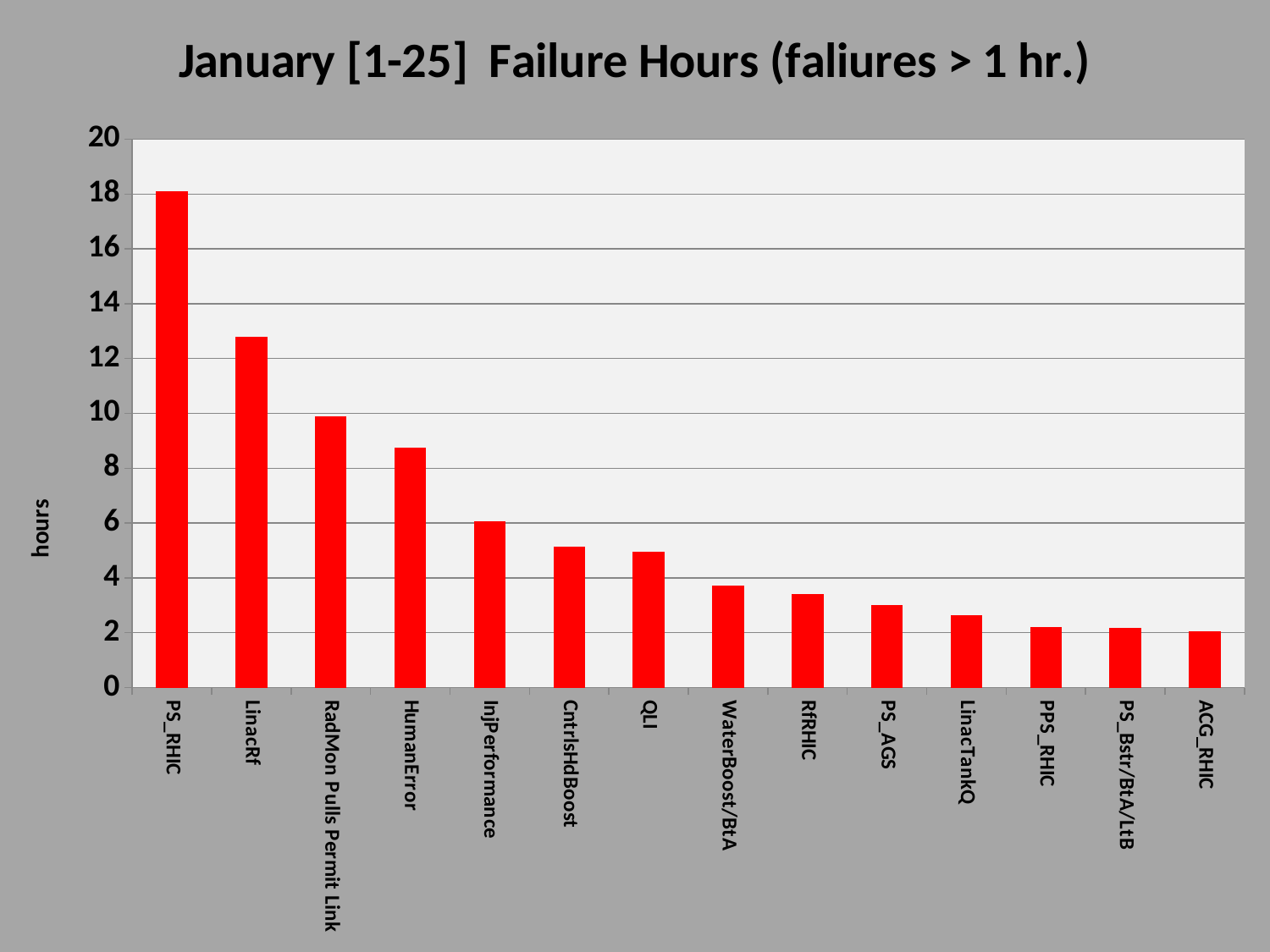
How many categories are plotted on the chart? 14 What kind of chart is shown on the slide? bar chart Is the value for CntrlsHdBoost greater or less than 4? greater Which has more failure hours, LinacRf or HumanError? LinacRf Do the values rise or fall moving from left to right along the x axis? fall What is the label on the vertical axis? hours Is the value for LinacRf greater or less than 12? greater Is the value for HumanError greater or less than 8? greater Which category has the highest failure hours? PS_RHIC